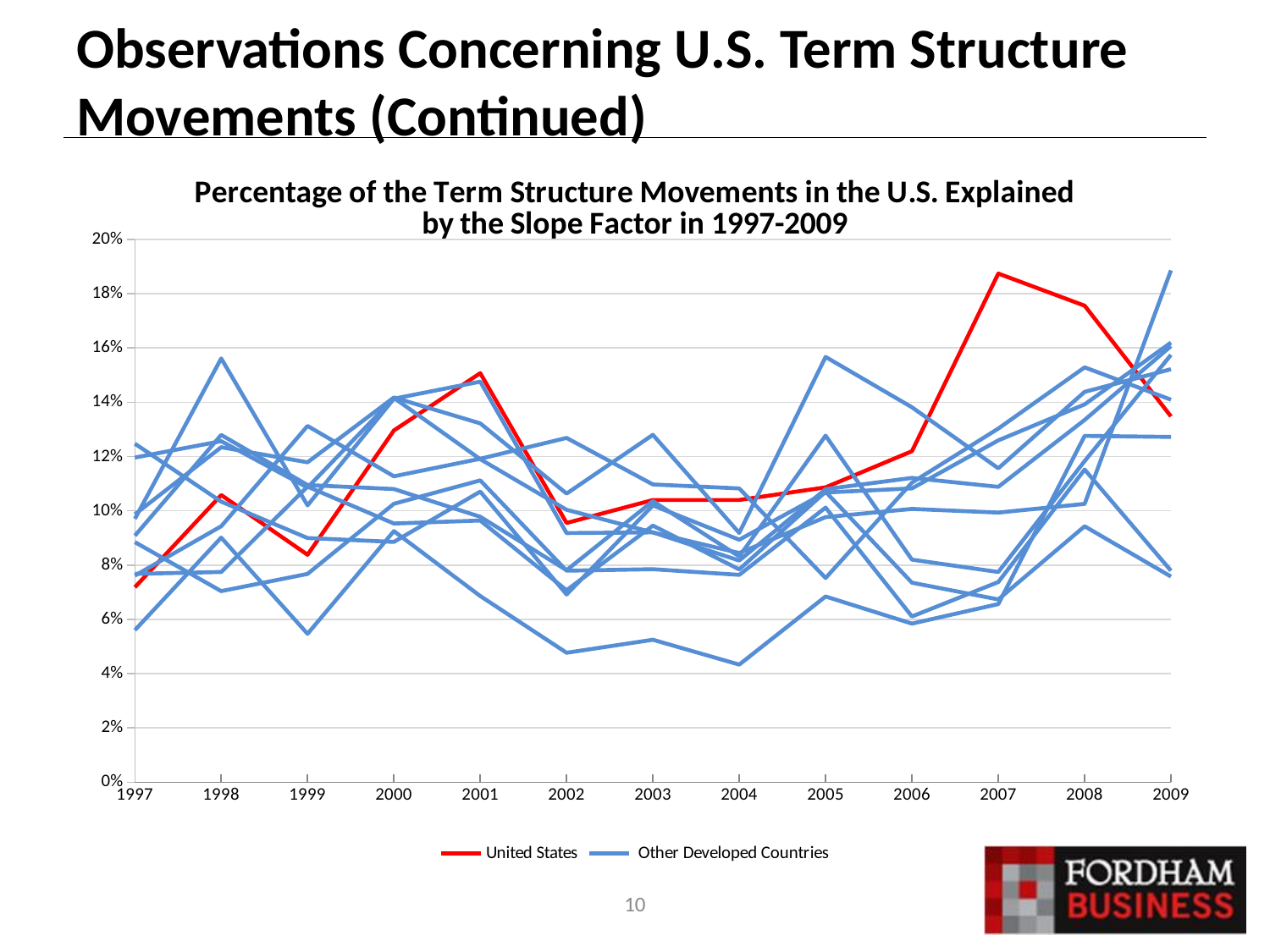
Which is larger for the United States: the value in 2007 or the value in 2009? 2007 What colour is the United States line in the chart? red How many years are plotted along the x axis? 13 Does the United States line rise or fall between 2006 and 2007? rise Is the value for the United States in 2001 greater or less than 14%? greater Is the value for the United States in 1997 greater or less than 8%? less How many series does the legend list? 2 What is the title of the chart? Percentage of the Term Structure Movements in the U.S. Explained by the Slope Factor in 1997-2009 What kind of chart is shown on the slide? line chart Is the value for the United States in 2007 greater or less than 18%? greater In which year does the United States line have its lowest value? 1997 In which year does the United States line reach its highest value? 2007